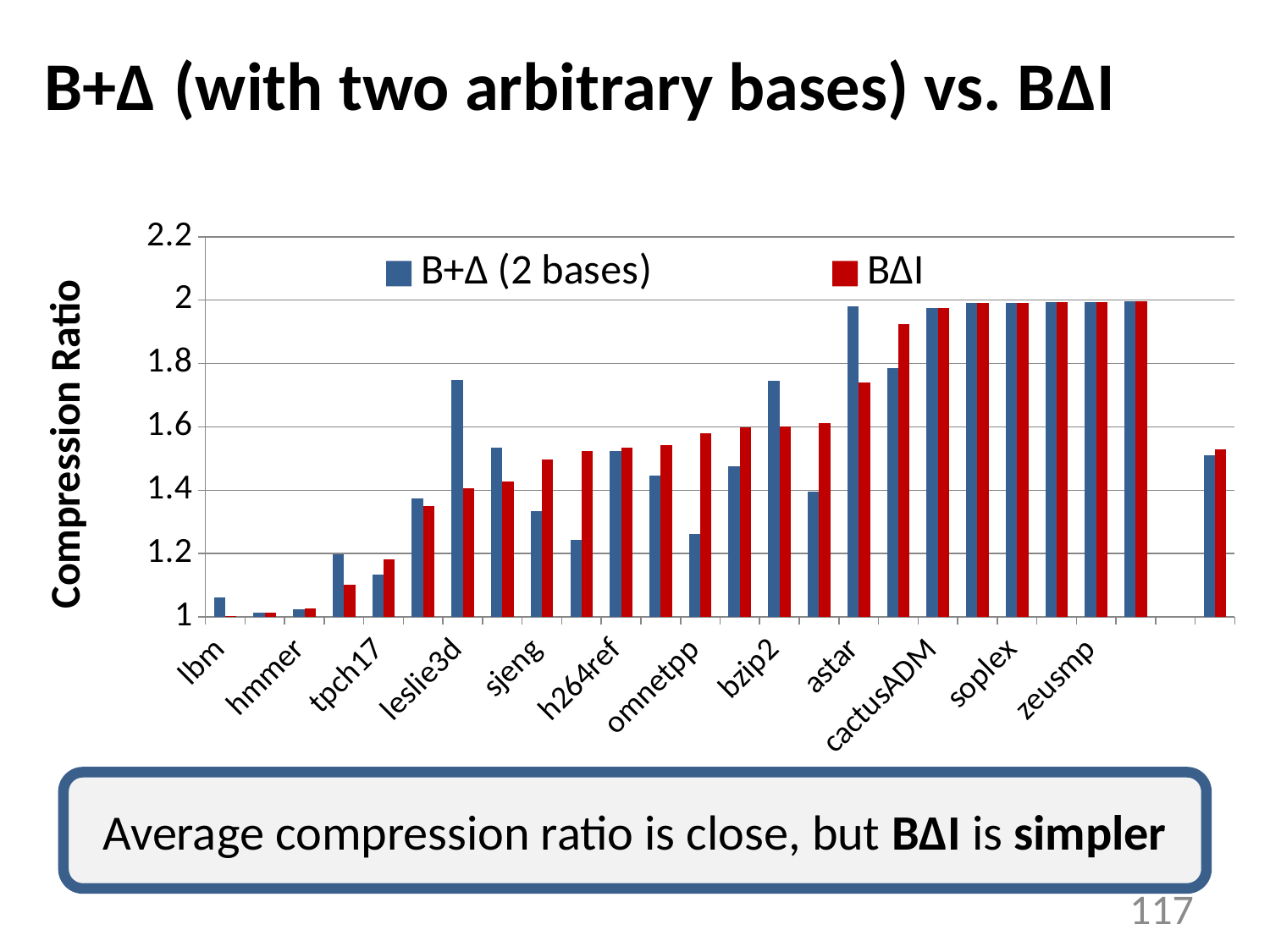
What kind of chart is shown on the slide? bar chart What is the label on the vertical axis? Compression Ratio Is the BΔI value for lbm greater or less than 1.2? less Is the B+Δ (2 bases) value for hmmer greater or less than 1.2? less Do the BΔI values generally rise or fall moving from lbm on the left to zeusmp on the right? rise What are the two series named in the legend? B+Δ (2 bases) and BΔI Is the BΔI value for zeusmp greater or less than 1.8? greater How many series does the legend list? 2